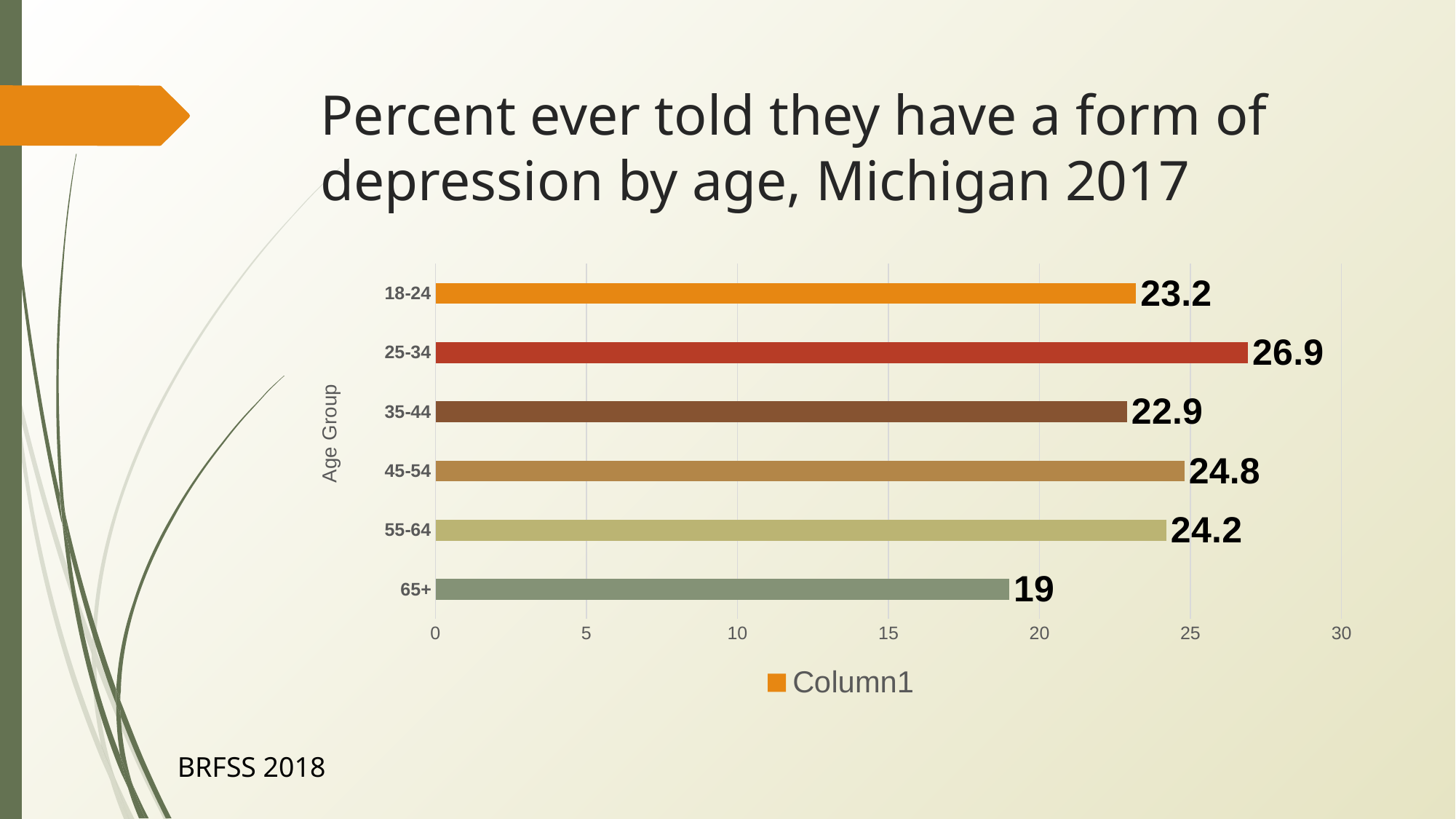
Which is larger, the value for 18-24 or the value for 55-64? 55-64 What is the label on the vertical axis of the chart? Age Group What is the value for the 45-54 age group? 24.8 What is the value for the 65+ age group? 19 What kind of chart is shown on the slide? bar chart How many age groups are shown in the chart? 6 What is the difference between the values for 25-34 and 65+? 7.9 Which age group has the highest value? 25-34 How many series does the legend list? 1 What is the value for the 25-34 age group? 26.9 Which age group has the lowest value? 65+ Is the value for 35-44 greater or less than 25? less